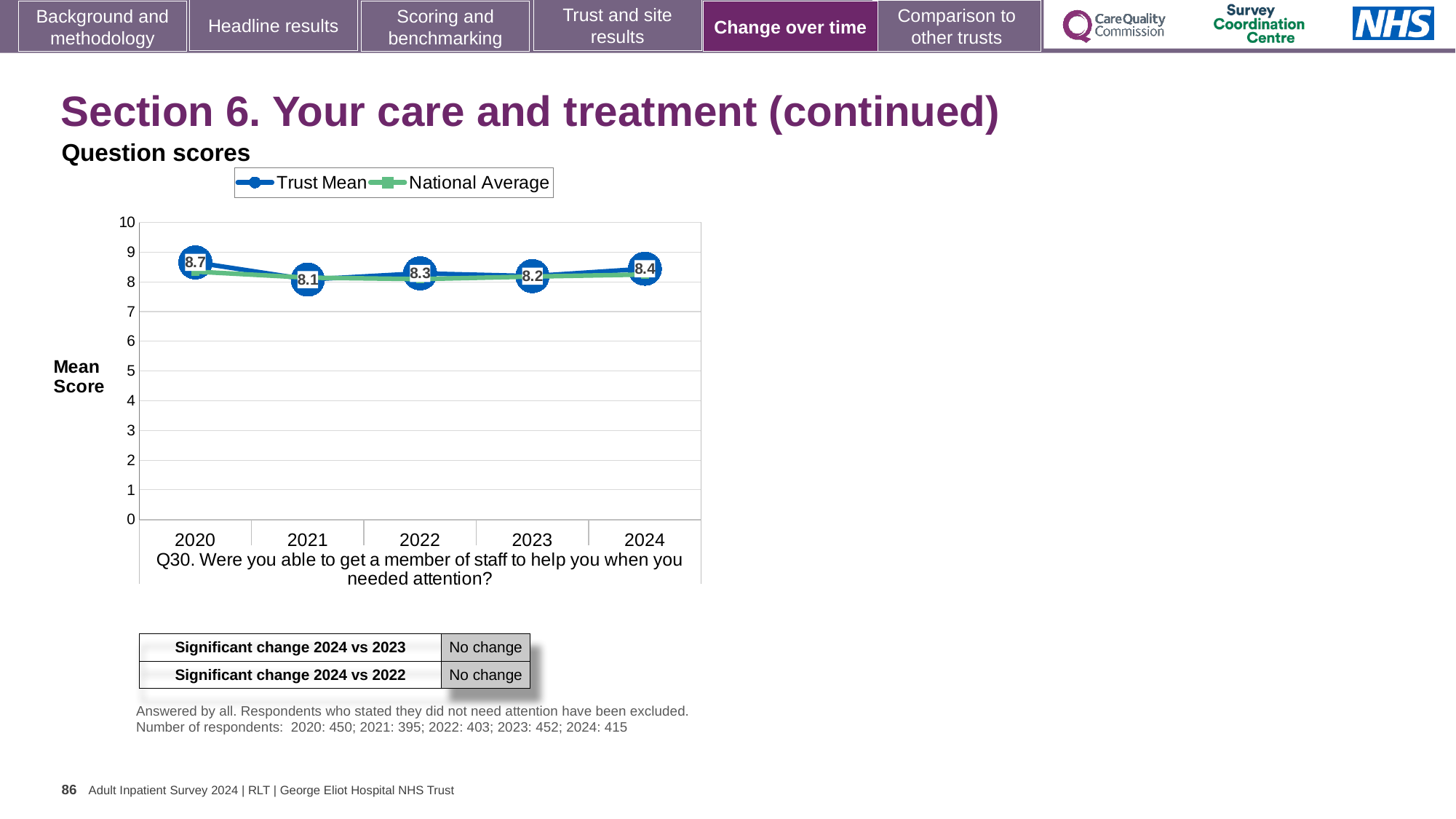
Does the Trust Mean rise or fall from 2020 to 2021? Fall In which year is the Trust Mean highest? 2020 How many series does the legend list? 2 Which year has the larger Trust Mean, 2023 or 2024? 2024 What is the Trust Mean for 2020? 8.7 What is the difference between the Trust Mean in 2020 and in 2021? 0.6 In which year is the Trust Mean lowest? 2021 How many years are plotted on the x axis? 5 What is the Trust Mean for 2022? 8.3 What kind of chart is shown? Line chart Is the National Average value for 2020 greater or less than 5? greater What is the Trust Mean for 2024? 8.4